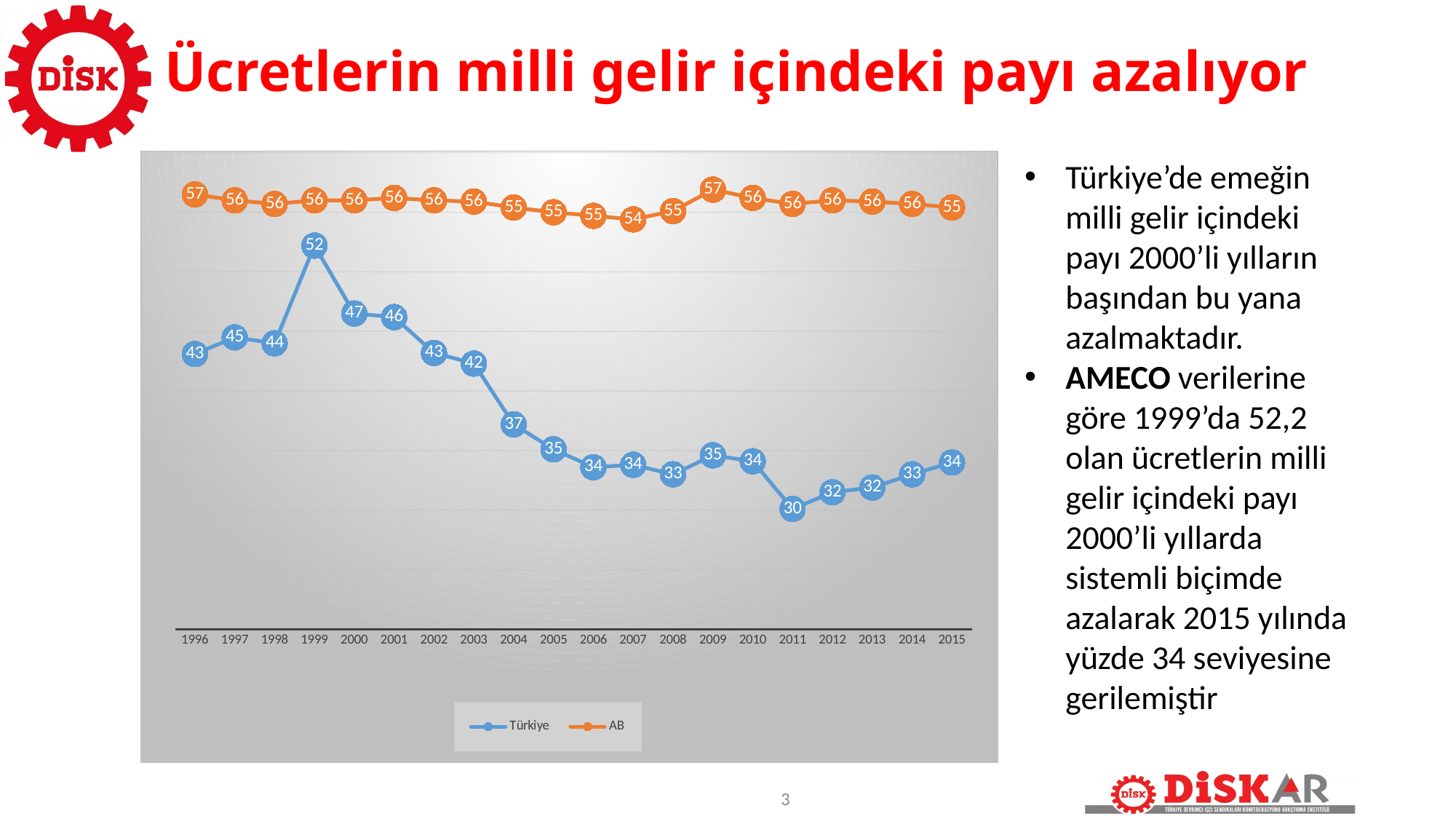
In which year does the Türkiye series reach its lowest value? 2011 How many series does the legend list? 2 Does the Türkiye series generally rise or fall from 1999 to 2011? fall How many years are shown on the x axis? 20 What is the value for Türkiye in 1999? 52 In which year does the Türkiye series reach its highest value? 1999 What is the value for AB in 2007? 54 What type of chart is shown on the slide? line chart What is the value for Türkiye in 2015? 34 Which series has the higher value in 2009, Türkiye or AB? AB What is the difference between the AB value and the Türkiye value in 2011? 26 What is the difference between the Türkiye value in 1999 and in 2015? 18